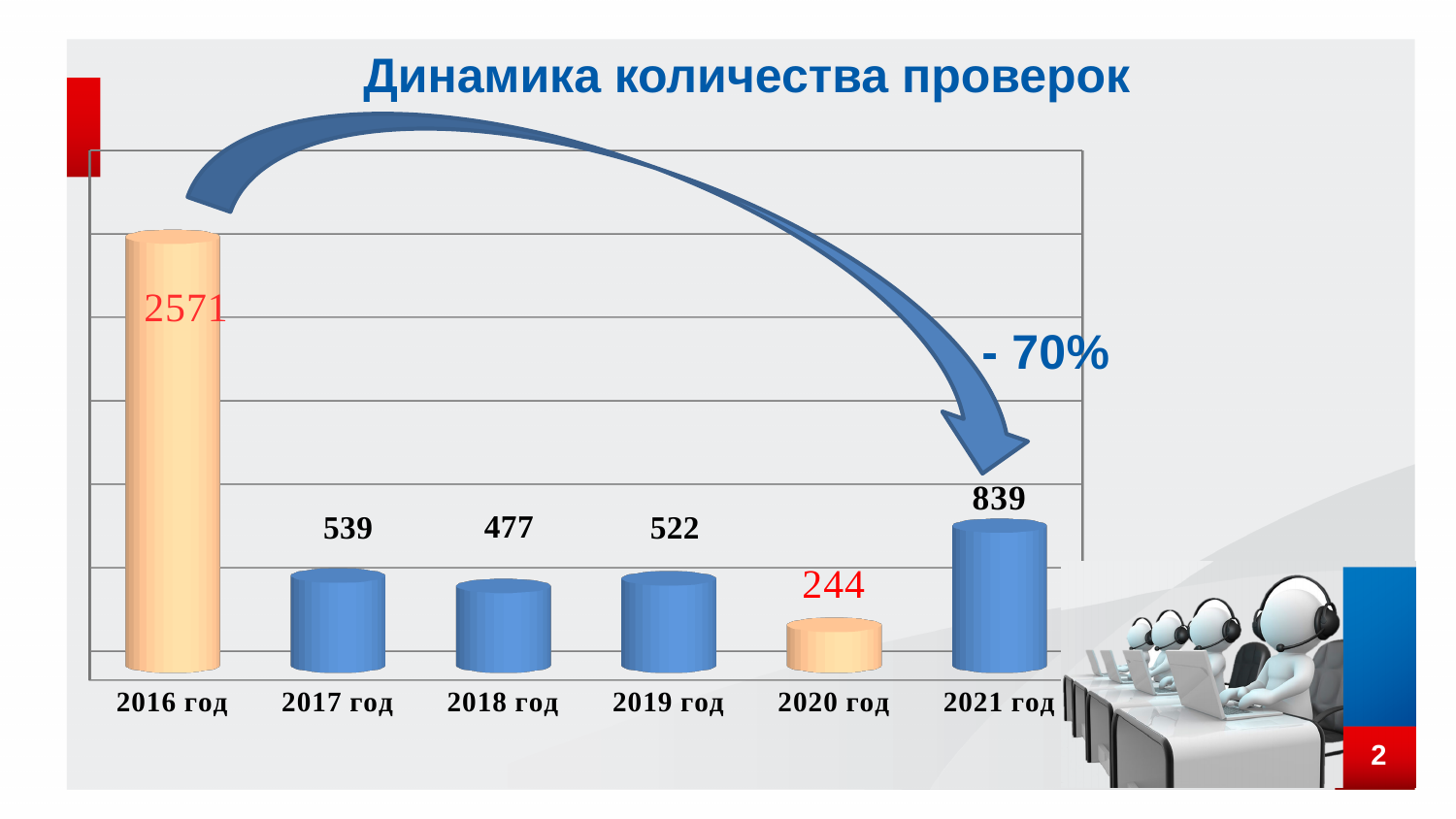
What is the difference between the values for 2017 год and 2018 год? 62 What is the title of the chart? Динамика количества проверок What is the value for 2020 год? 244 How many years are shown on the chart? 6 What kind of chart is shown on the slide? bar chart Which year has the highest value? 2016 год What is the value for 2016 год? 2571 Which is larger, the value for 2017 год or the value for 2019 год? 2017 год What is the value for 2018 год? 477 What is the value for 2021 год? 839 What is the difference between the values for 2016 год and 2021 год? 1732 Which year has the lowest value? 2020 год